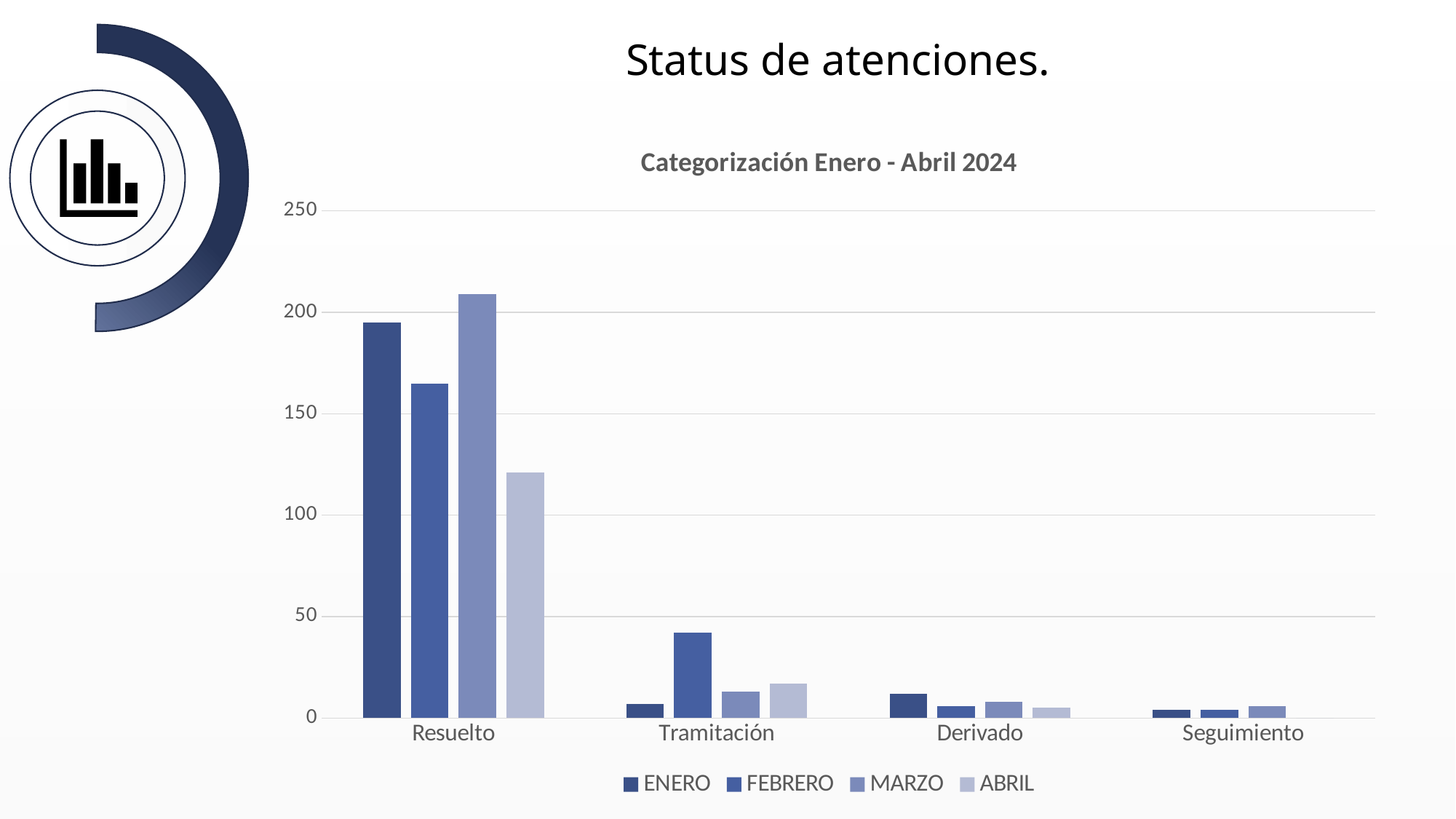
Within the Tramitación category, which series has the highest value? FEBRERO Which category has the highest MARZO value? Resuelto How many series does the chart's legend list? 4 Is the MARZO value for Resuelto greater or less than 200? greater For Resuelto, which is larger: the ENERO value or the FEBRERO value? ENERO What kind of chart is shown on the slide? bar chart How many categories are shown on the x axis of the chart? 4 What is the title of the chart? Categorización Enero - Abril 2024 Is the ABRIL value for Resuelto greater or less than 150? less Is the ENERO value for Resuelto greater or less than 150? greater Which category has the highest ENERO value? Resuelto